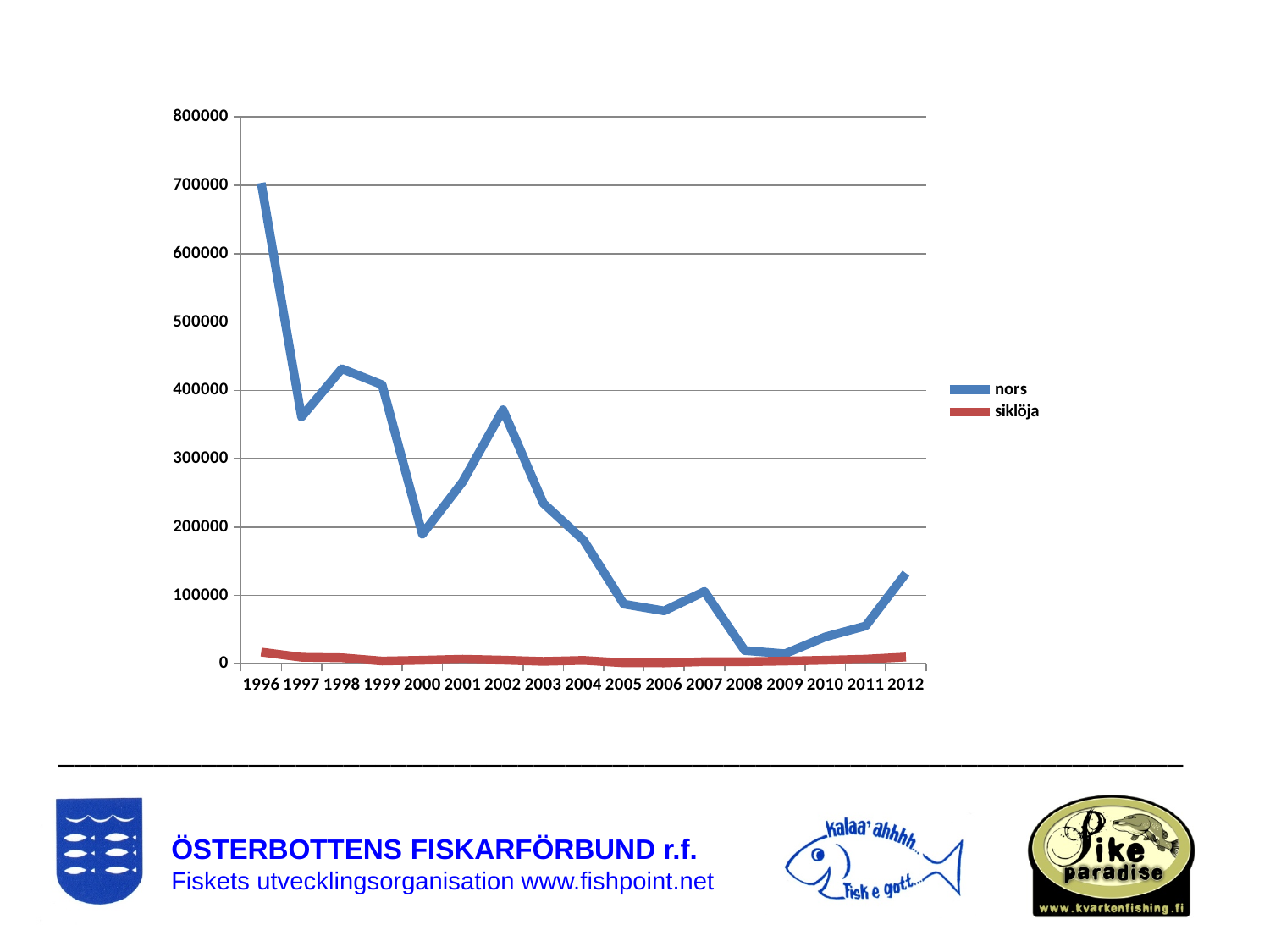
Is the value for nors in 2002 greater or less than 300000? greater What are the two entries in the legend? nors and siklöja How many series does the legend list? 2 Is the value for nors in 2005 greater or less than 100000? less Which series has the larger value in 1996, nors or siklöja? nors Is the value for nors in 1996 greater or less than 600000? greater Which series is drawn in blue? nors Does the value for nors generally rise or fall from 1996 to 2012? fall In which year is the value for nors highest? 1996 What kind of chart is shown on the slide? line chart How many years are shown along the x axis? 17